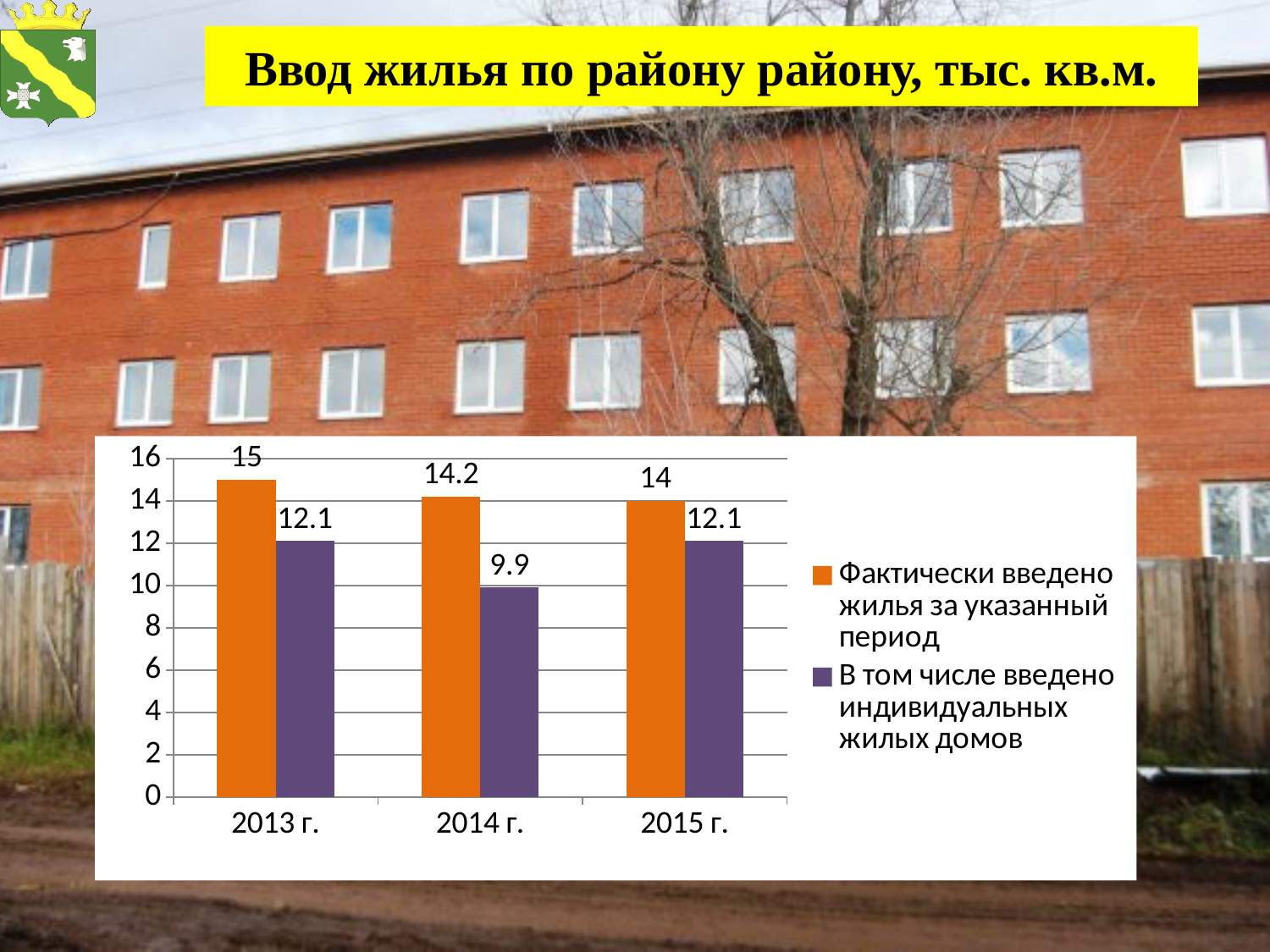
What is the value of "Фактически введено жилья за указанный период" for 2015 г.? 14 What is the difference between "Фактически введено жилья за указанный период" and "В том числе введено индивидуальных жилых домов" in 2014 г.? 4.3 In which year is "Фактически введено жилья за указанный период" the highest? 2013 г. How many years are shown on the x axis of the chart? 3 How many series does the legend list? 2 Is the value of "Фактически введено жилья за указанный период" for 2014 г. greater or less than 12? greater What is the value of "Фактически введено жилья за указанный период" for 2013 г.? 15 Which is larger: "В том числе введено индивидуальных жилых домов" in 2013 г. or in 2014 г.? 2013 г. What kind of chart is shown on the slide? bar chart What is the value of "В том числе введено индивидуальных жилых домов" for 2014 г.? 9.9 Does "Фактически введено жилья за указанный период" rise or fall from 2013 г. to 2015 г.? fall In which year is "В том числе введено индивидуальных жилых домов" the lowest? 2014 г.